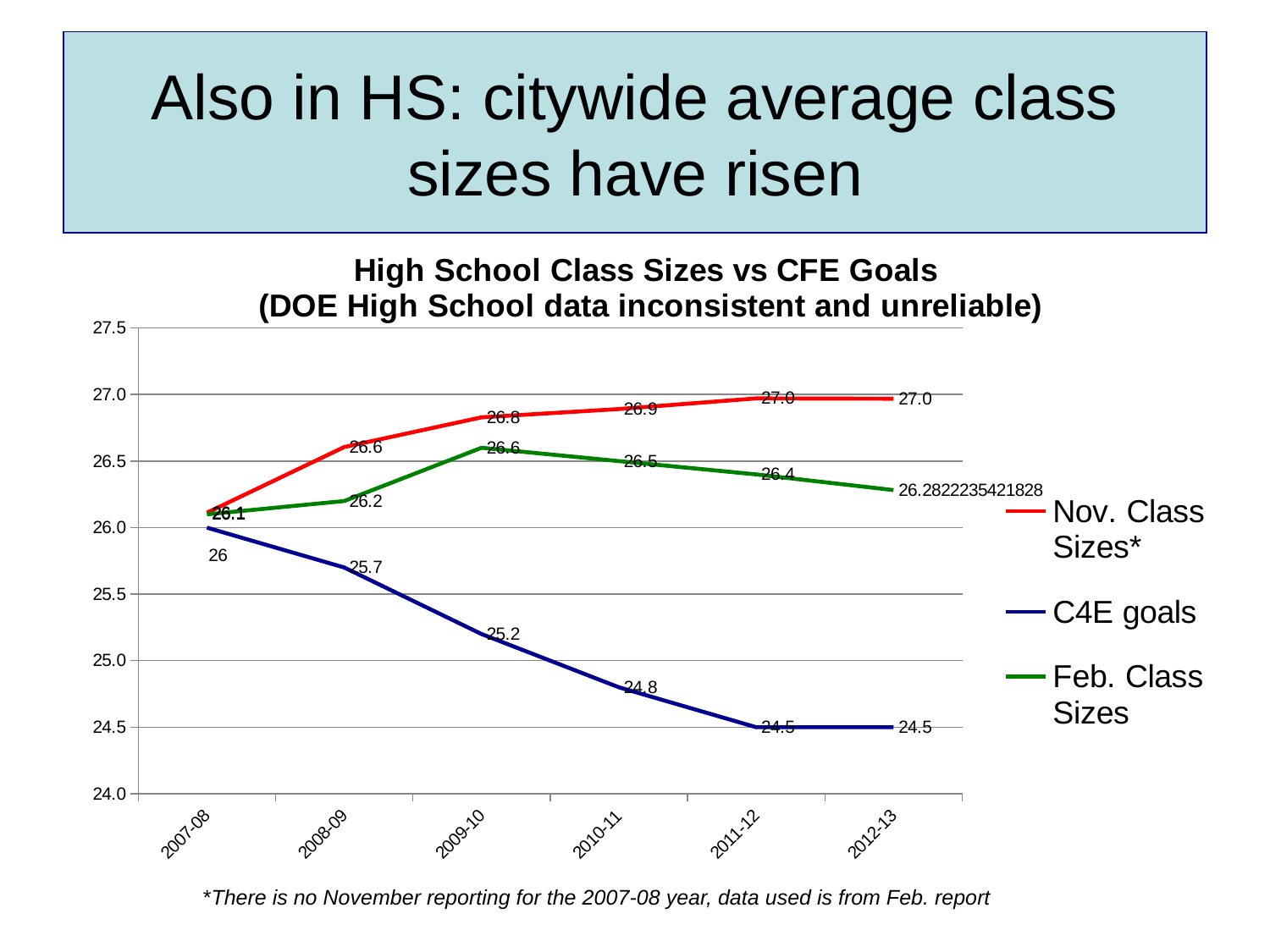
What is the difference between the Nov. Class Sizes value and the C4E goals value in 2012-13? 2.5 In which year is the C4E goals series at its highest? 2007-08 What is the Nov. Class Sizes value for 2012-13? 27.0 What is the C4E goals value for 2010-11? 24.8 How many series does the legend list? 3 How many school years are plotted along the x axis? 6 What is the Feb. Class Sizes value for 2011-12? 26.4 Is the Feb. Class Sizes value for 2012-13 greater or less than 26.5? less What type of chart is shown on the slide? line chart Do the C4E goals values rise or fall from 2007-08 to 2012-13? fall In which year is the Feb. Class Sizes series at its highest? 2009-10 In 2009-10, which is larger: Nov. Class Sizes or Feb. Class Sizes? Nov. Class Sizes